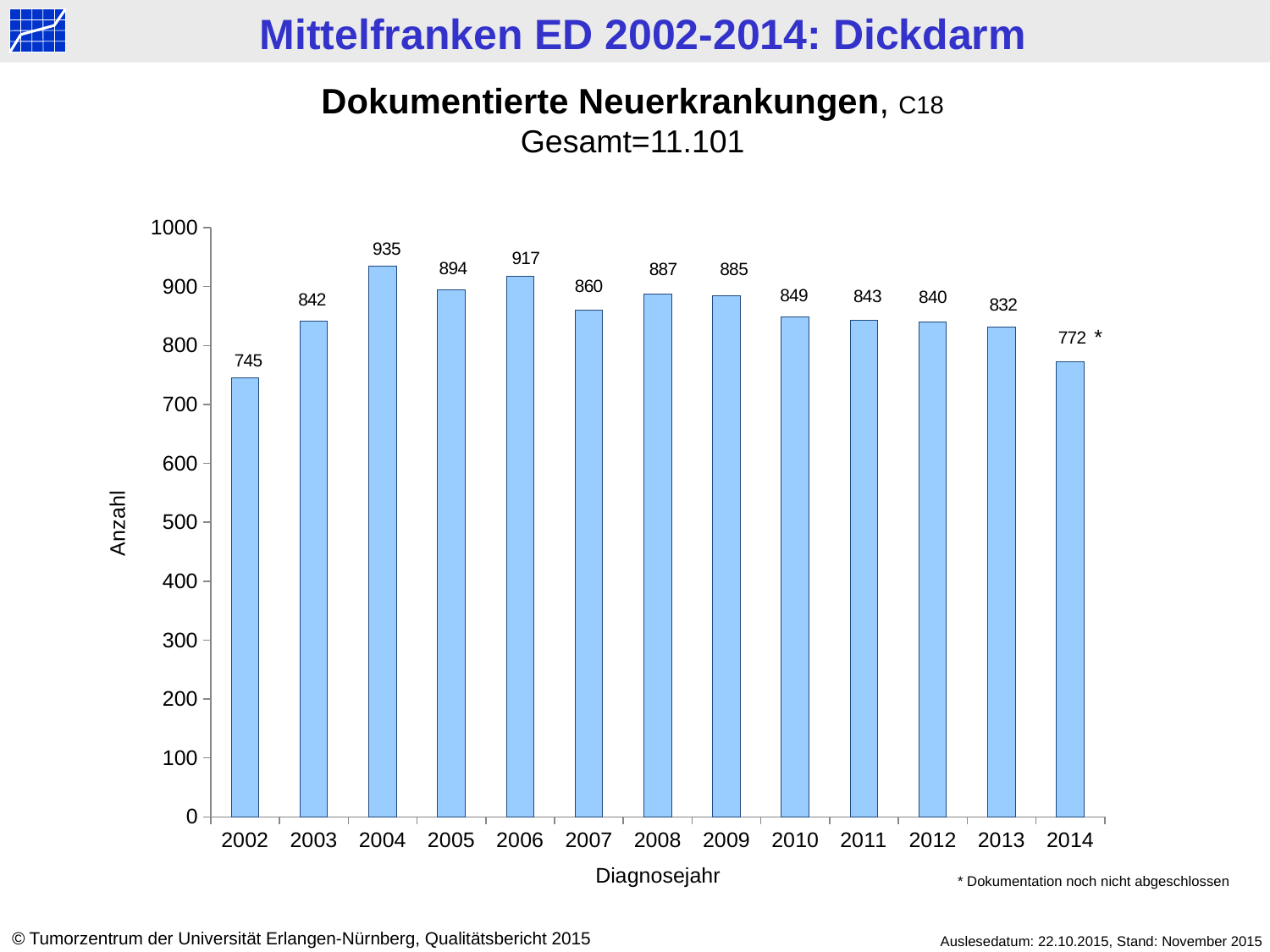
What is the value shown for the year 2014? 772 What is the difference between the values for 2006 and 2007? 57 What kind of chart is shown on the slide? bar chart What total (Gesamt) is stated in the chart subtitle? 11.101 What is the number of documented new cases (Anzahl) for 2004? 935 Which year has the highest number of documented new cases? 2004 Which year has the lowest number of documented new cases? 2002 Is the value for 2013 greater or less than 800? greater What is the value shown for the year 2002? 745 Which year has a larger value, 2008 or 2009? 2008 How many years (bars) are shown on the chart? 13 What is the difference between the values for 2004 and 2002? 190